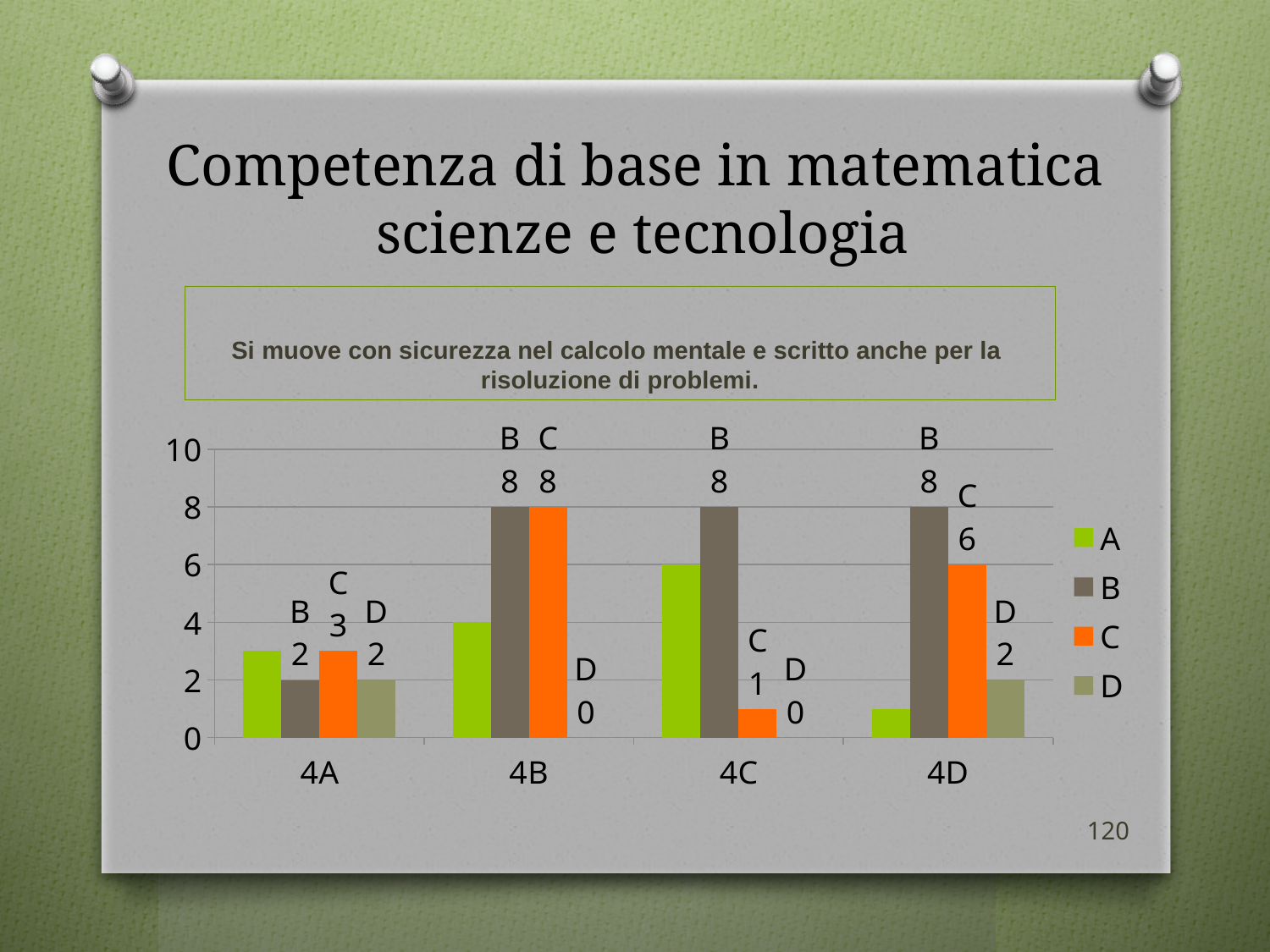
Is the value of series A for category 4C greater or less than 4? greater What is the value of series C for category 4D? 6 For category 4C, which is larger: the value of series B or series C? B How many categories are shown on the x axis? 4 What is the value of series C for category 4A? 3 How many series does the legend list? 4 What kind of chart is shown on the slide? bar chart For category 4D, what is the difference between the values of series C and series D? 4 What is the value of series B for category 4C? 8 What is the value of series D for category 4B? 0 Is the value of series A for category 4D greater or less than 2? less Which category has the highest value for series C? 4B